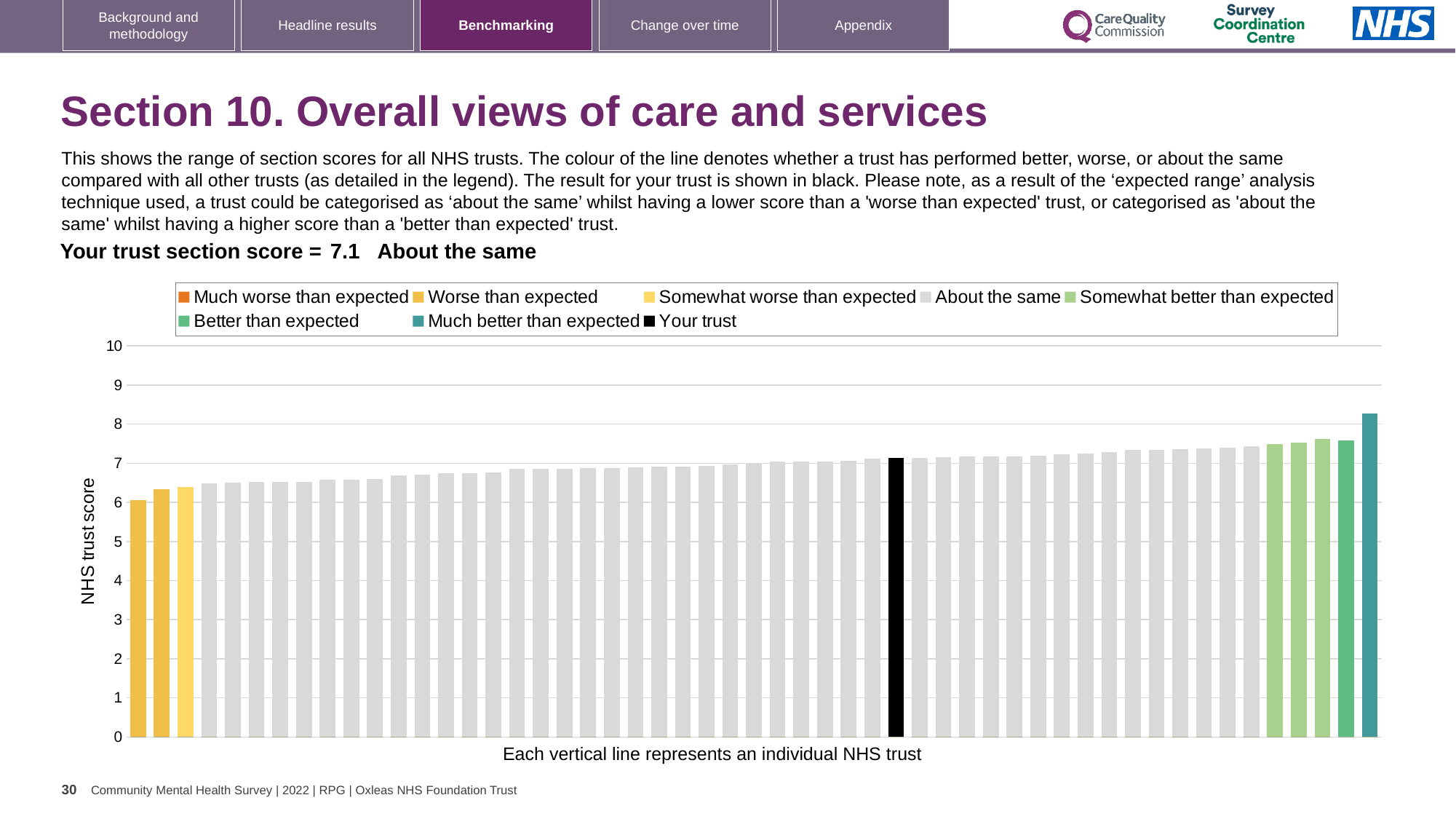
What is the section score for your trust? 7.1 How many bars are coloured yellow/gold at the left of the chart? 3 How many entries does the chart legend list? 8 What is the label on the vertical axis? NHS trust score Which is larger: the value for your trust or the value of the rightmost bar? the rightmost bar What kind of chart is shown on the slide? bar chart Do the bar values rise or fall from left to right along the x axis? rise Which category is your trust placed in for this section? About the same Is the value of the lowest bar greater or less than 7? less What colour is the bar representing your trust? black Is the value for your trust greater or less than 6? greater Is the value of the highest bar greater or less than 8? greater